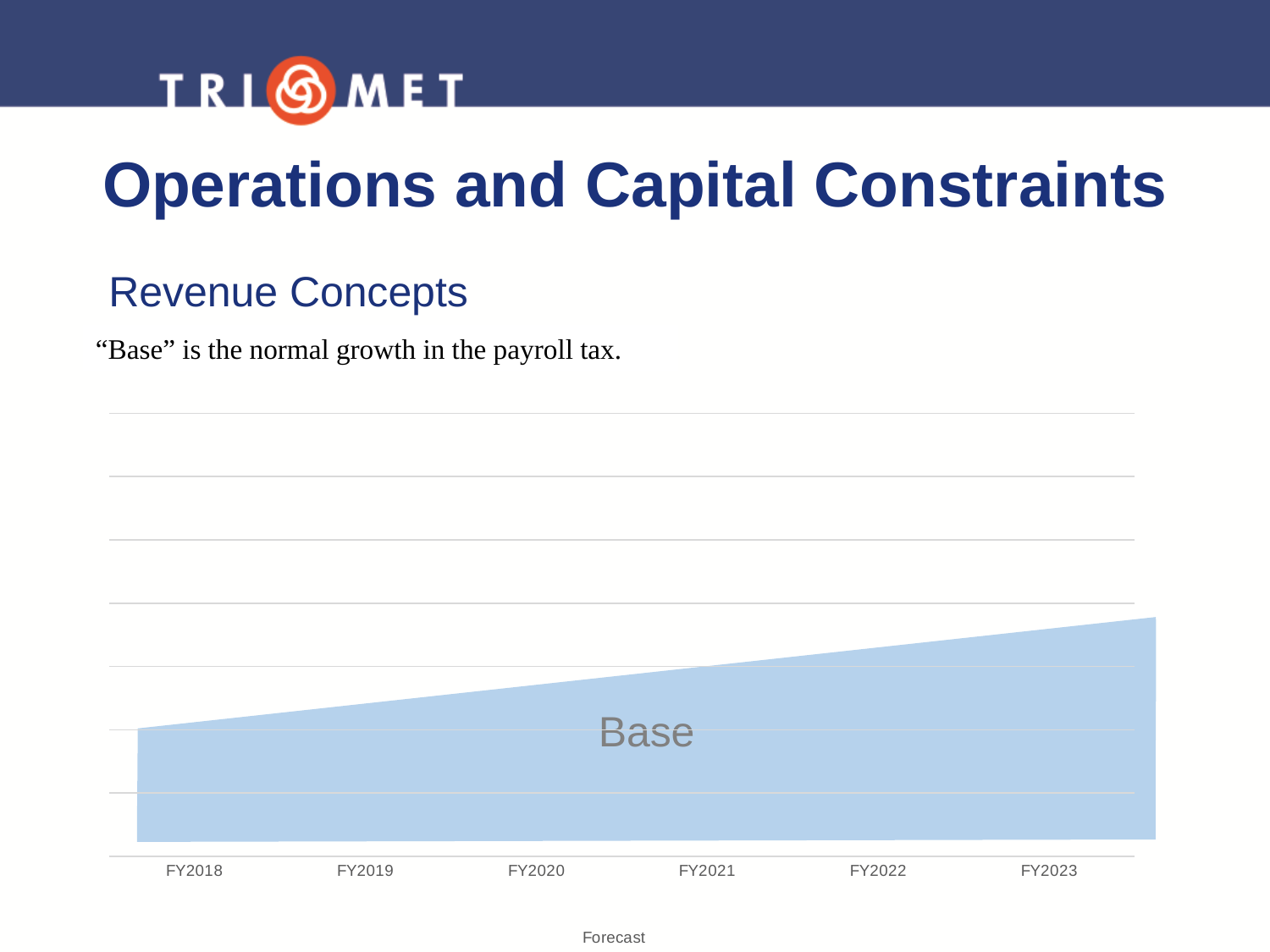
Which fiscal year has the lowest Base value in the chart? FY2018 Is the Base value for FY2023 larger or smaller than the Base value for FY2018? Larger Is the Base value for FY2019 larger or smaller than the Base value for FY2022? Smaller What label is printed inside the shaded area of the chart? Base What kind of chart is shown on the slide? Area chart Which fiscal year has the highest Base value in the chart? FY2023 What is the first fiscal year shown on the x axis of the chart? FY2018 Does the Base area rise or fall from FY2018 to FY2023? Rise How many fiscal years are shown along the x axis of the chart? 6